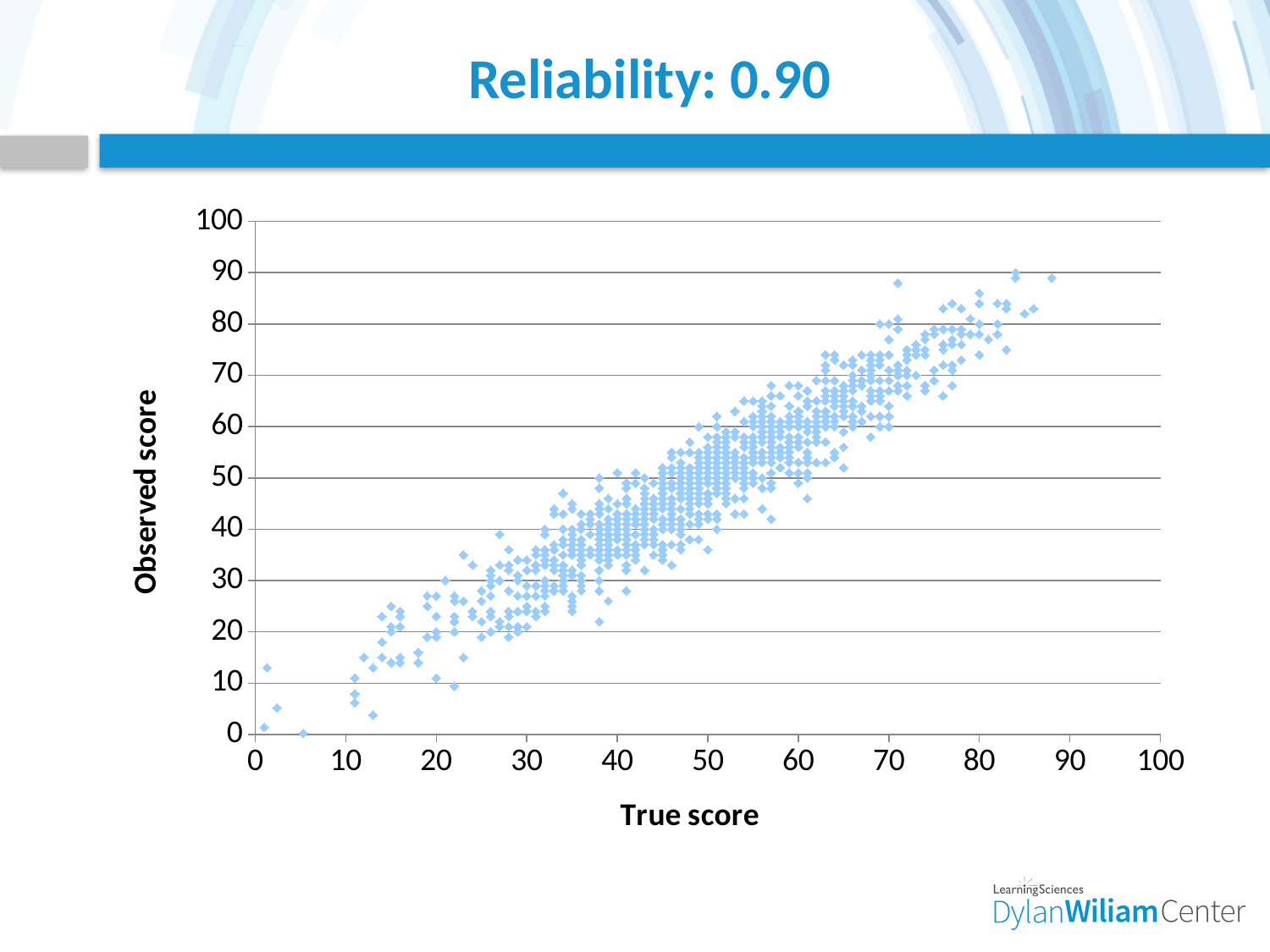
What is the maximum value shown on the x axis (True score)? 100 Are the observed scores for points with a true score around 15 greater or less than 40? less What is the title of the slide's chart? Reliability: 0.90 As the true score increases along the x axis, do the observed scores generally rise or fall? Rise Are the observed scores for points with a true score around 80 greater or less than 50? greater What is the label on the x axis of the chart? True score What is the maximum value shown on the y axis (Observed score)? 100 What kind of chart is shown on the slide? Scatter plot Does any plotted point have an observed score above 90? No What is the interval between consecutive tick marks on the y axis? 10